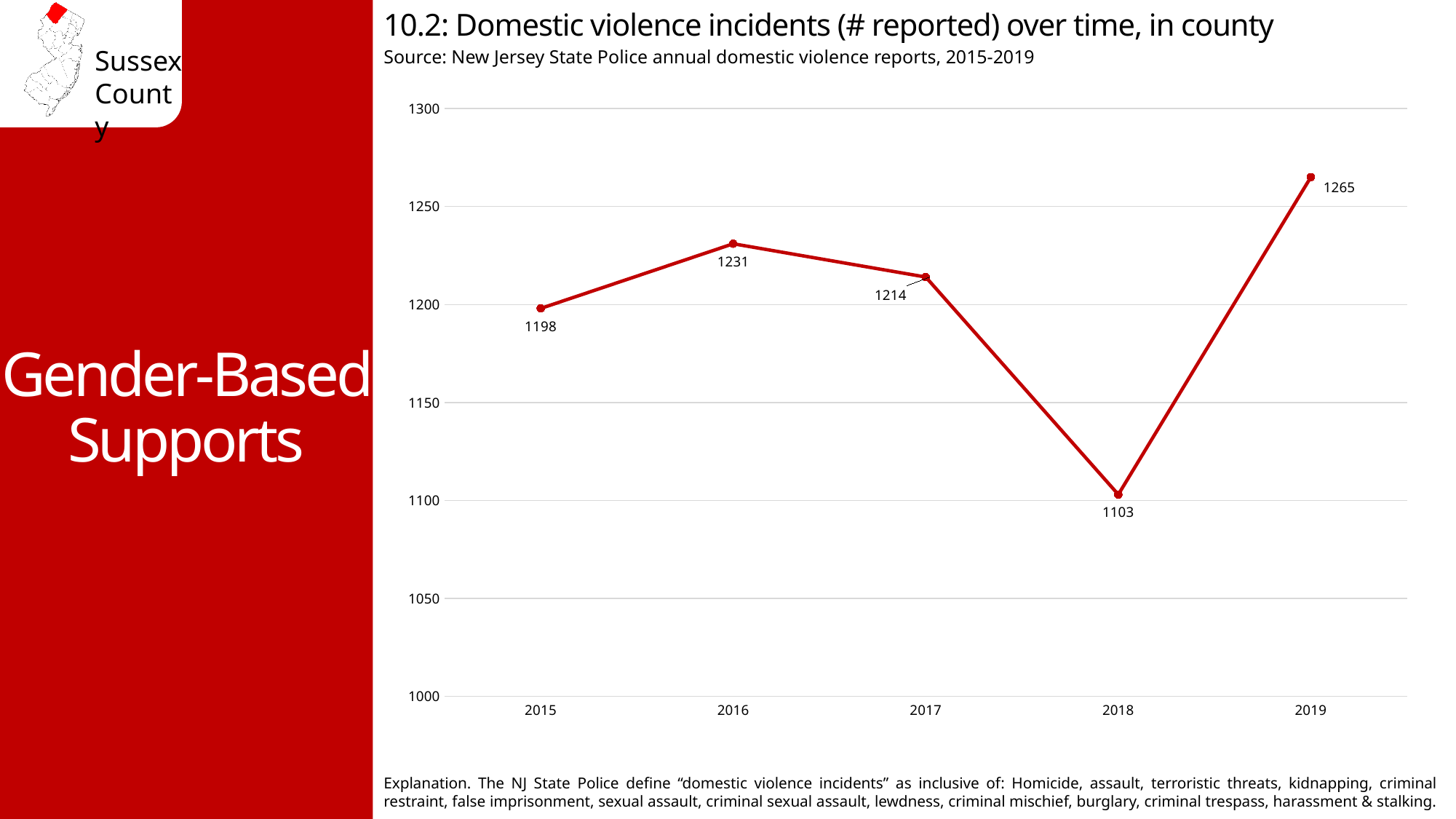
Which year had the lowest number of reported domestic violence incidents? 2018 What is the difference between the number of incidents in 2016 and in 2017? 17 What was the number of reported domestic violence incidents in 2018? 1103 Which year had more reported incidents, 2016 or 2017? 2016 What was the number of reported domestic violence incidents in 2015? 1198 What is the difference between the number of incidents in 2019 and in 2018? 162 Did the number of reported incidents rise or fall from 2017 to 2018? fall Which year had the highest number of reported domestic violence incidents? 2019 Is the value for 2018 greater or less than 1150? less How many years are plotted on the chart? 5 What kind of chart is shown on the slide? line chart What was the number of reported domestic violence incidents in 2019? 1265